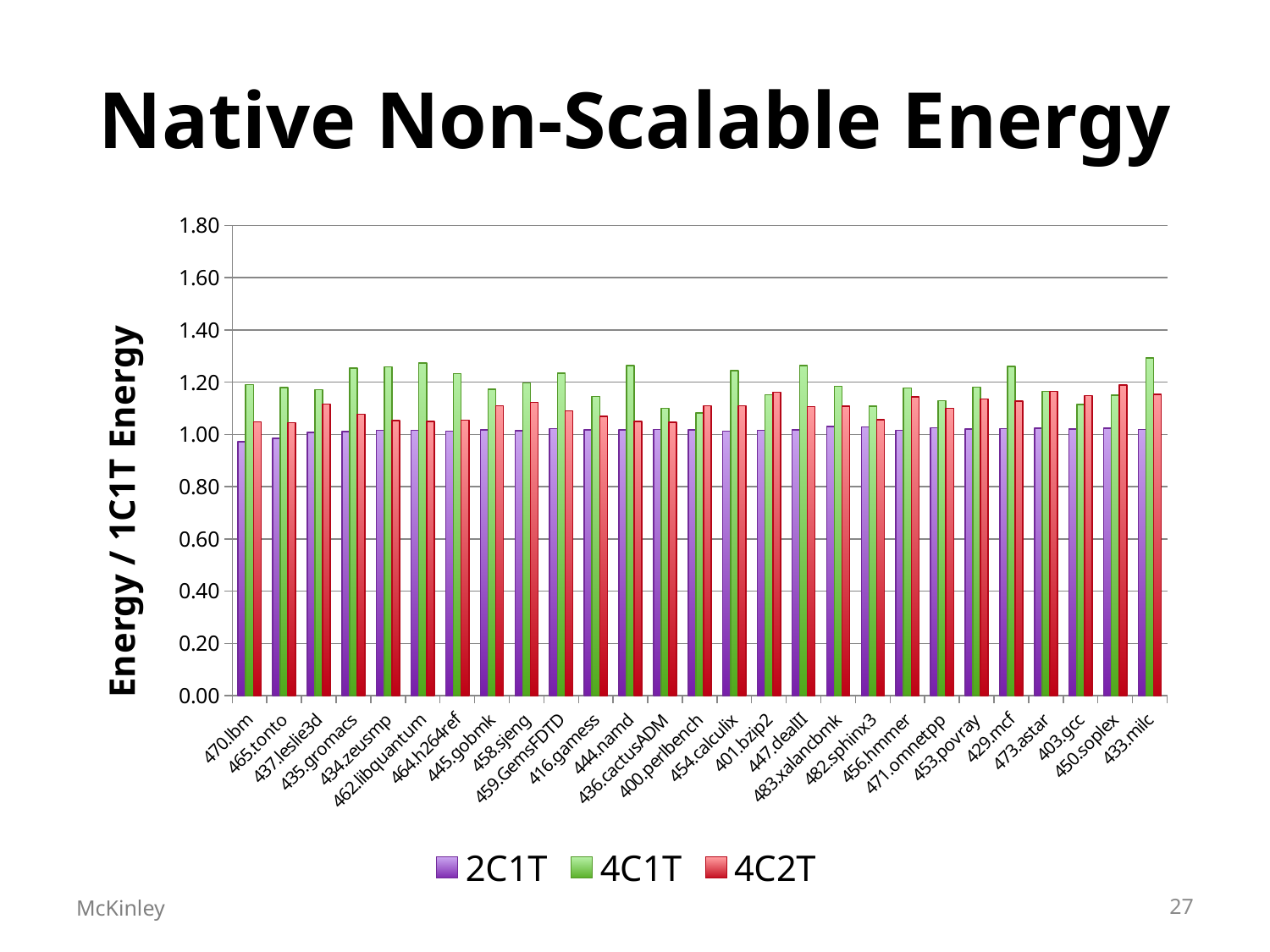
How many benchmark categories are plotted along the x axis? 27 Is the 4C2T value for 450.soplex greater or less than 1.00? greater What is the title of the chart? Native Non-Scalable Energy Is the 4C1T value for 433.milc greater or less than 1.20? greater Is the 4C2T value for 470.lbm greater or less than 1.20? less For 470.lbm, which series has the larger value, 4C1T or 4C2T? 4C1T What kind of chart is shown on the slide? bar chart For 433.milc, which series has the larger value, 4C1T or 4C2T? 4C1T What is the label on the y axis? Energy / 1C1T Energy How many series does the legend list? 3